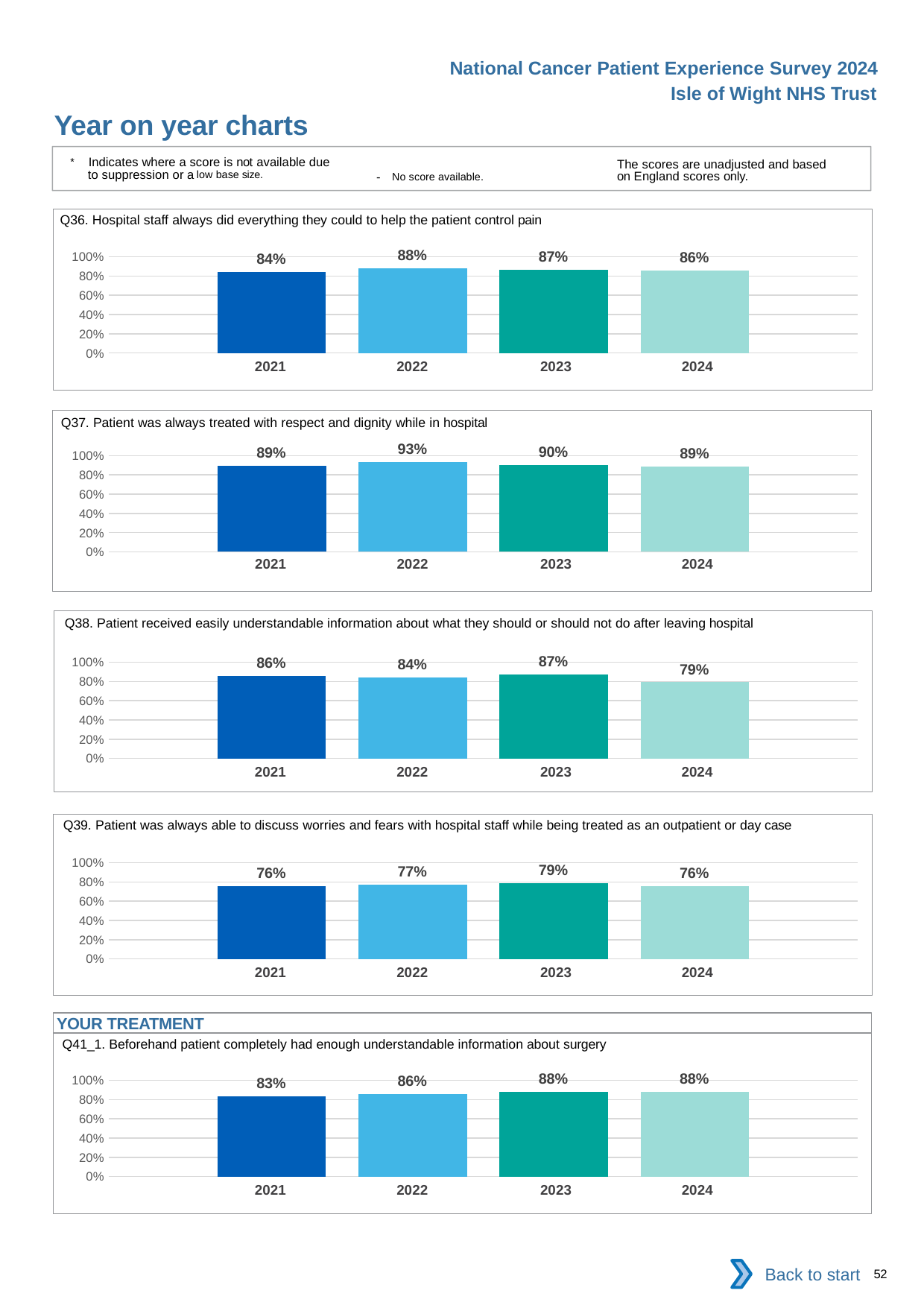
In the Q37 chart (patient was always treated with respect and dignity while in hospital), which year has the highest value? 2022 What kind of chart is the Q37 chart? Bar chart How many years (categories) are shown in the Q36 chart? 4 In the Q41_1 chart, is the value for 2024 greater or less than 80%? greater In the Q39 chart (patient was always able to discuss worries and fears with hospital staff while being treated as an outpatient or day case), which is larger, the value for 2022 or the value for 2023? 2023 In the Q38 chart (patient received easily understandable information about what they should or should not do after leaving hospital), which year has the lowest value? 2024 In the Q41_1 chart, do the values rise or fall from 2021 to 2023? Rise In the Q41_1 chart (beforehand patient completely had enough understandable information about surgery), what is the value for 2021? 83% In the Q38 chart, what is the difference between the 2023 value and the 2024 value? 8% What is the section heading shown above the Q41_1 chart? YOUR TREATMENT In the Q36 chart (hospital staff always did everything they could to help the patient control pain), what is the value for 2022? 88% In the Q39 chart, what is the difference between the 2023 value and the 2021 value? 3%